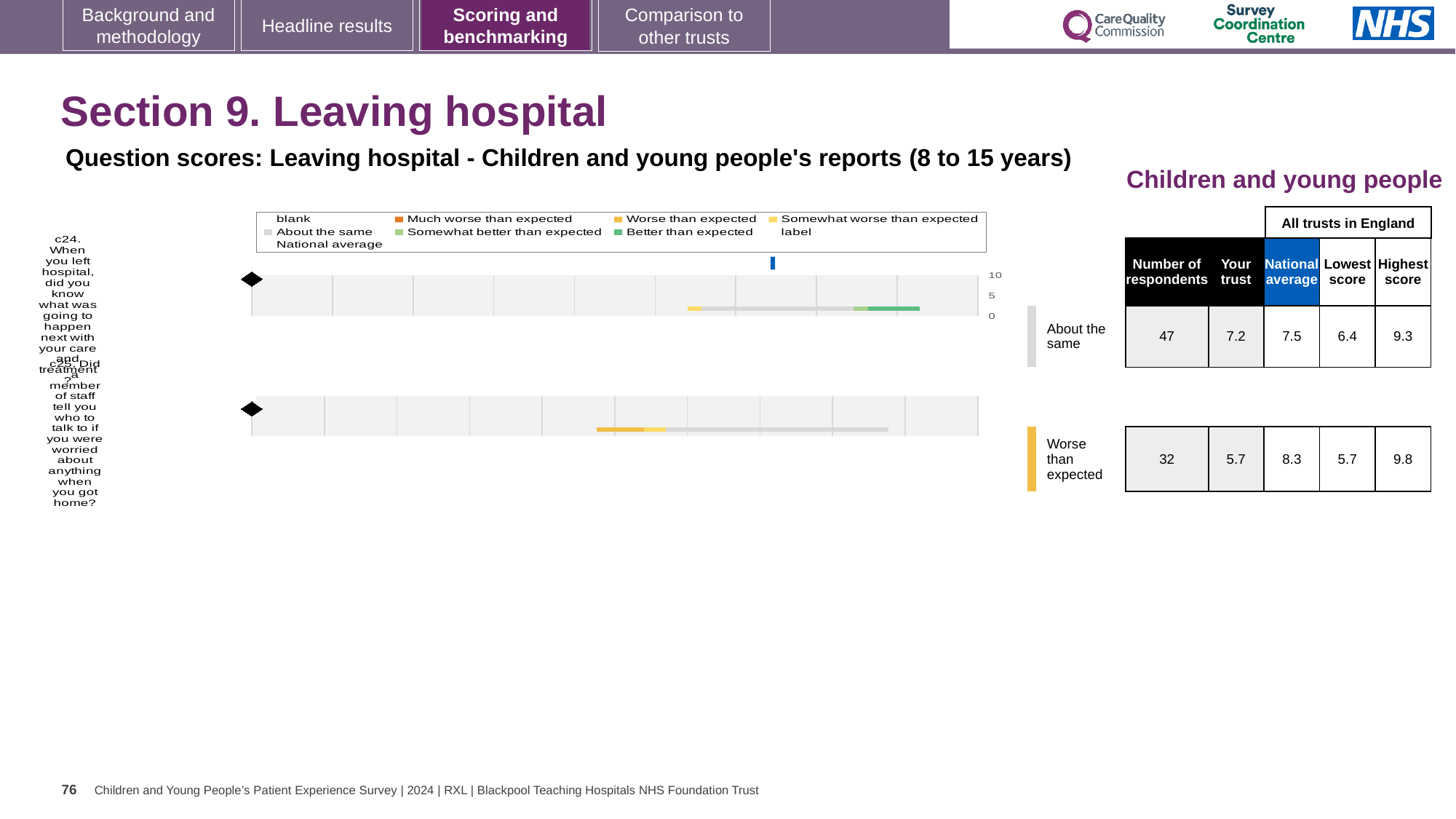
What is the difference between the national average and the trust's score for question c25? 2.6 How many respondents answered question c25? 32 How many entries does the chart legend list? 9 What is the 'Your trust' score for question c24 (did you know what was going to happen next with your care and treatment)? 7.2 What kind of chart is used to show the question scores for leaving hospital? Bar chart How many survey questions (rows) are plotted in the chart? 2 What is the national average score for question c24? 7.5 What benchmark category is shown for question c25? Worse than expected What is the national average score for question c25? 8.3 What is the 'Your trust' score for question c25 (did a member of staff tell you who to talk to if you were worried when you got home)? 5.7 What is the highest score among all trusts in England for question c24? 9.3 Which question has the higher 'Your trust' score, c24 or c25? c24